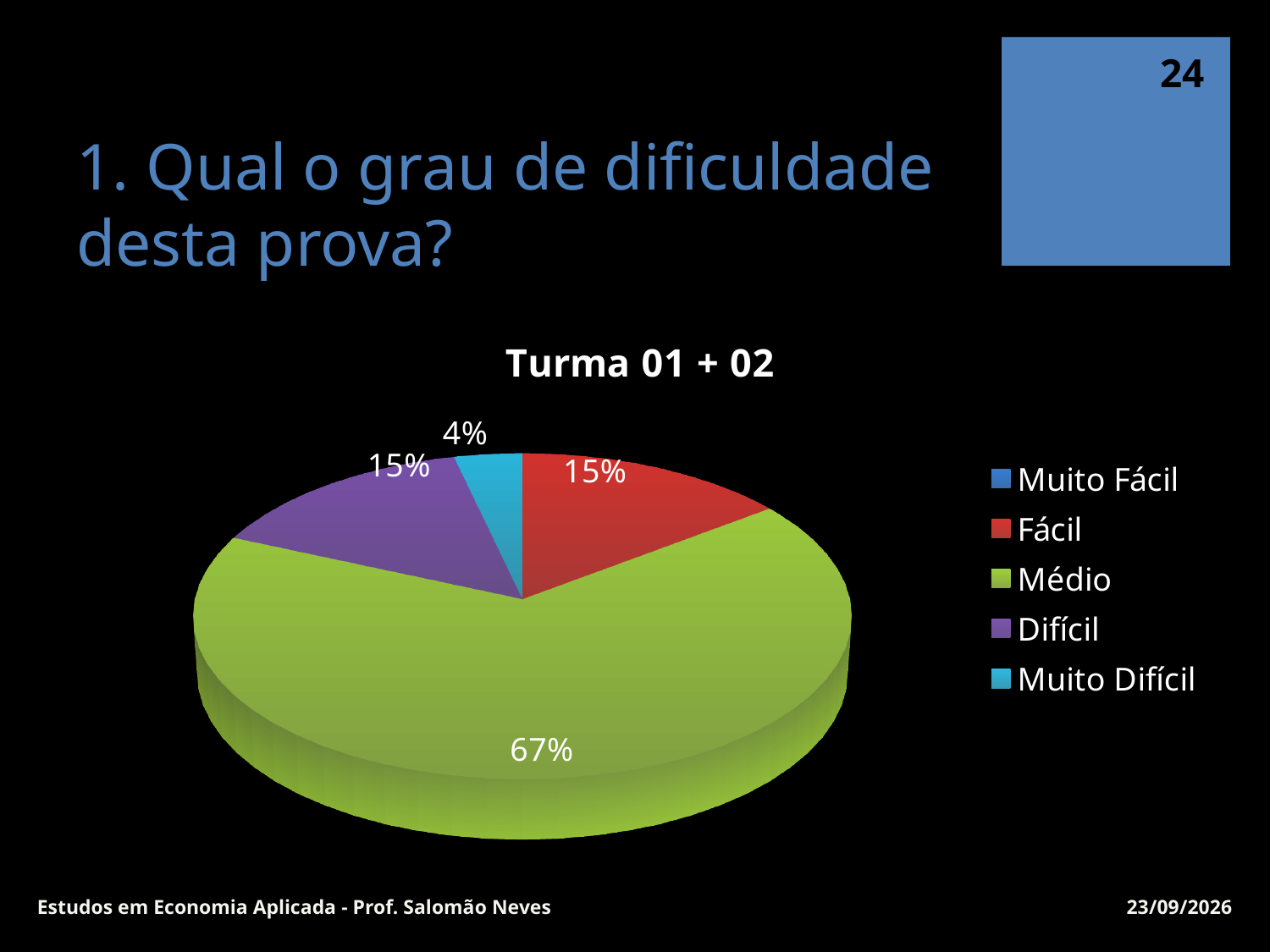
What is the title of the chart? Turma 01 + 02 How many entries does the legend list? 5 Which category has the largest slice of the pie? Médio What kind of chart is shown on the slide? pie chart What percentage is shown for Difícil? 15% What percentage of the pie is labelled for Médio? 67% What is the difference between the Médio and Fácil percentages? 52% What percentage is shown for Muito Difícil? 4% Which is larger, the Médio slice or the Difícil slice? Médio What is the difference between the Fácil and Muito Difícil percentages? 11% Which slice has the smallest percentage label shown on the pie? Muito Difícil What percentage is shown for Fácil? 15%